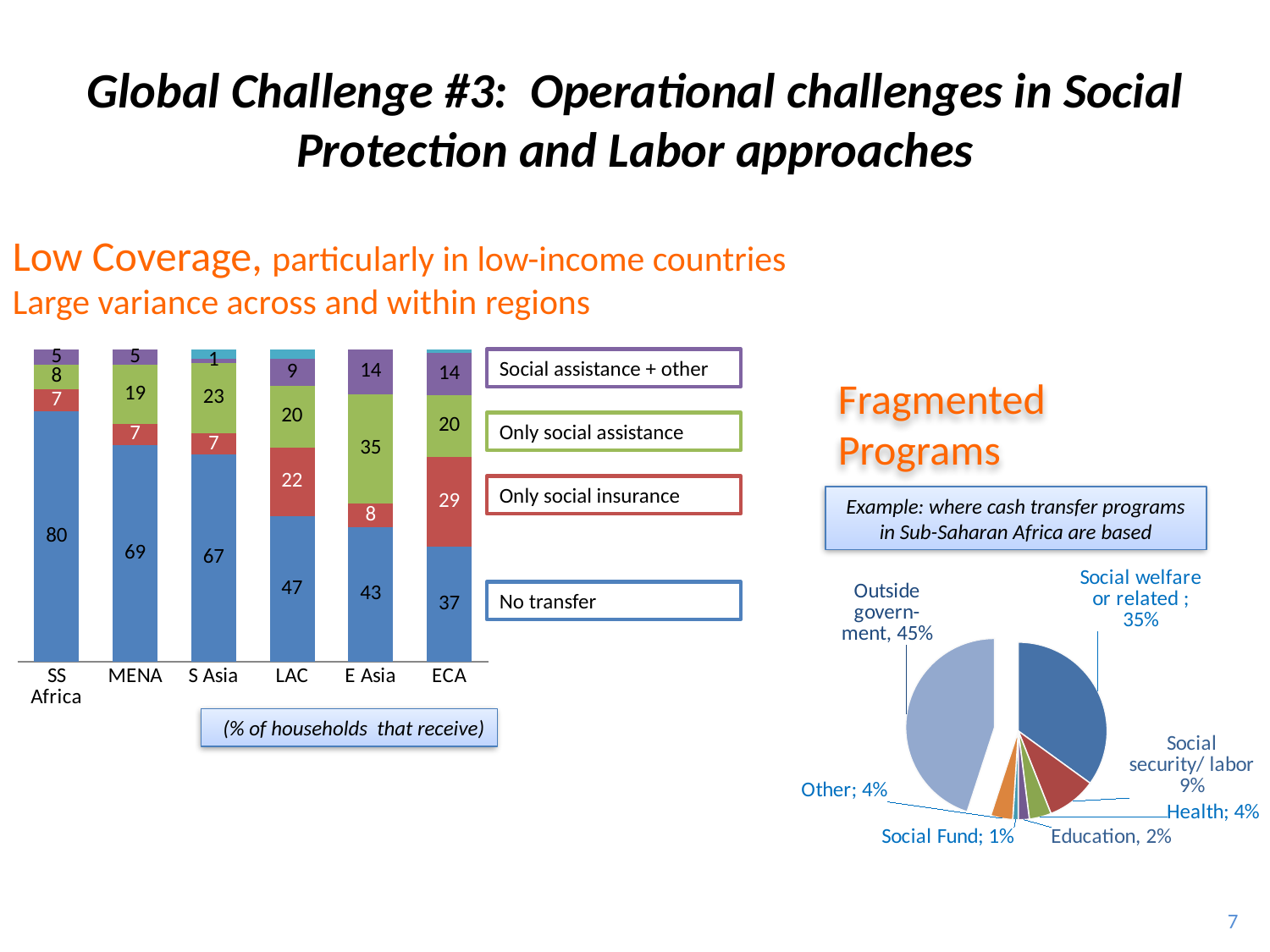
In the stacked bar chart on the left, what is the 'Only social insurance' value for ECA? 29 In the pie chart on the right, what share of cash transfer programs are based outside government? 45% In the stacked bar chart on the left, what percentage of households in SS Africa receive no transfer? 80 In the stacked bar chart on the left, is the 'Only social insurance' value larger for LAC or for E Asia? LAC In the stacked bar chart on the left, what is the difference between the 'No transfer' values for SS Africa and ECA? 43 In the stacked bar chart on the left, how many regions are shown on the x axis? 6 What type of chart is the chart on the right of the slide? Pie chart In the stacked bar chart on the left, which region has the lowest 'No transfer' value? ECA In the stacked bar chart on the left, which region has the highest 'No transfer' value? SS Africa In the stacked bar chart on the left, what is the total of the four labelled segments for MENA? 100 In the pie chart on the right, which category has the smallest share? Social Fund In the stacked bar chart on the left, what is the 'Only social assistance' value for E Asia? 35